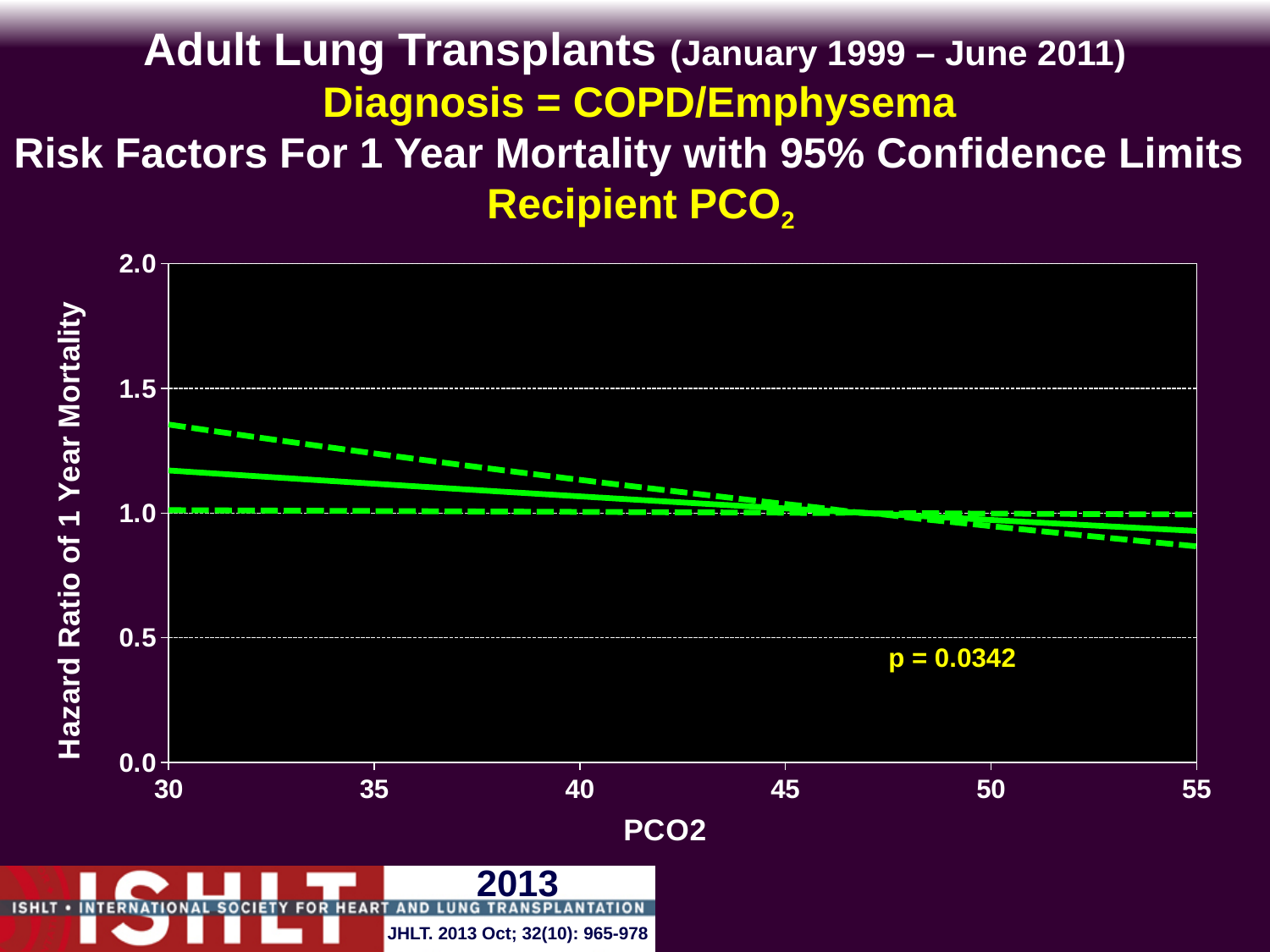
Is the lower 95% confidence limit (lower dashed line) at PCO2 = 55 greater or less than 1.0? less Is the hazard ratio (solid line) at PCO2 = 40 greater or less than 1.5? less What is the maximum value shown on the y axis? 2.0 Does the solid hazard ratio line rise or fall as PCO2 increases from 30 to 55? fall Is the hazard ratio (solid line) at PCO2 = 30 greater or less than 1.0? greater What kind of chart is shown on the slide? line chart Which is larger: the hazard ratio (solid line) at PCO2 = 30 or at PCO2 = 55? PCO2 = 30 What p-value is printed on the chart? p = 0.0342 How many lines are plotted on the chart? 3 What is the label of the y axis? Hazard Ratio of 1 Year Mortality